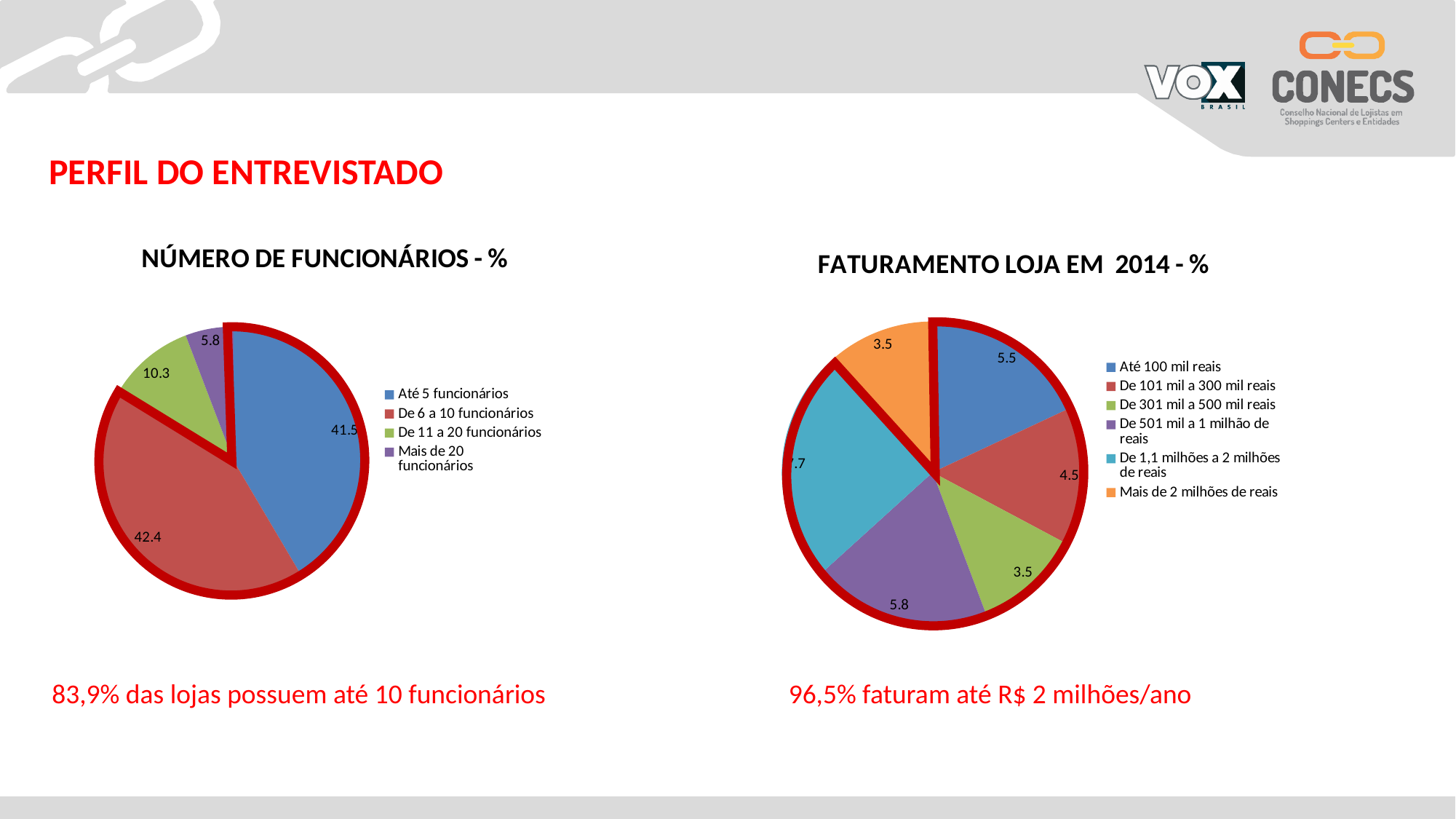
In the chart titled "NÚMERO DE FUNCIONÁRIOS - %", which category has the largest share? De 6 a 10 funcionários In the chart titled "NÚMERO DE FUNCIONÁRIOS - %", what is the value for "De 6 a 10 funcionários"? 42.4 In the chart titled "NÚMERO DE FUNCIONÁRIOS - %", how many categories does the pie show? 4 In the chart titled "FATURAMENTO LOJA EM 2014 - %", which colour represents "Mais de 2 milhões de reais"? Orange In the chart titled "NÚMERO DE FUNCIONÁRIOS - %", what is the difference between the values for "De 6 a 10 funcionários" and "Até 5 funcionários"? 0.9 In the chart titled "NÚMERO DE FUNCIONÁRIOS - %", is the value for "De 11 a 20 funcionários" larger or smaller than the value for "Mais de 20 funcionários"? Larger In the chart titled "FATURAMENTO LOJA EM 2014 - %", how many categories does the legend list? 6 In the chart titled "FATURAMENTO LOJA EM 2014 - %", what value is printed for "De 101 mil a 300 mil reais"? 4.5 In the chart titled "NÚMERO DE FUNCIONÁRIOS - %", which category has the smallest share? Mais de 20 funcionários What kind of chart is the one titled "NÚMERO DE FUNCIONÁRIOS - %"? Pie chart In the chart titled "FATURAMENTO LOJA EM 2014 - %", what value is printed for "Até 100 mil reais"? 5.5 In the chart titled "NÚMERO DE FUNCIONÁRIOS - %", what is the value for "Até 5 funcionários"? 41.5